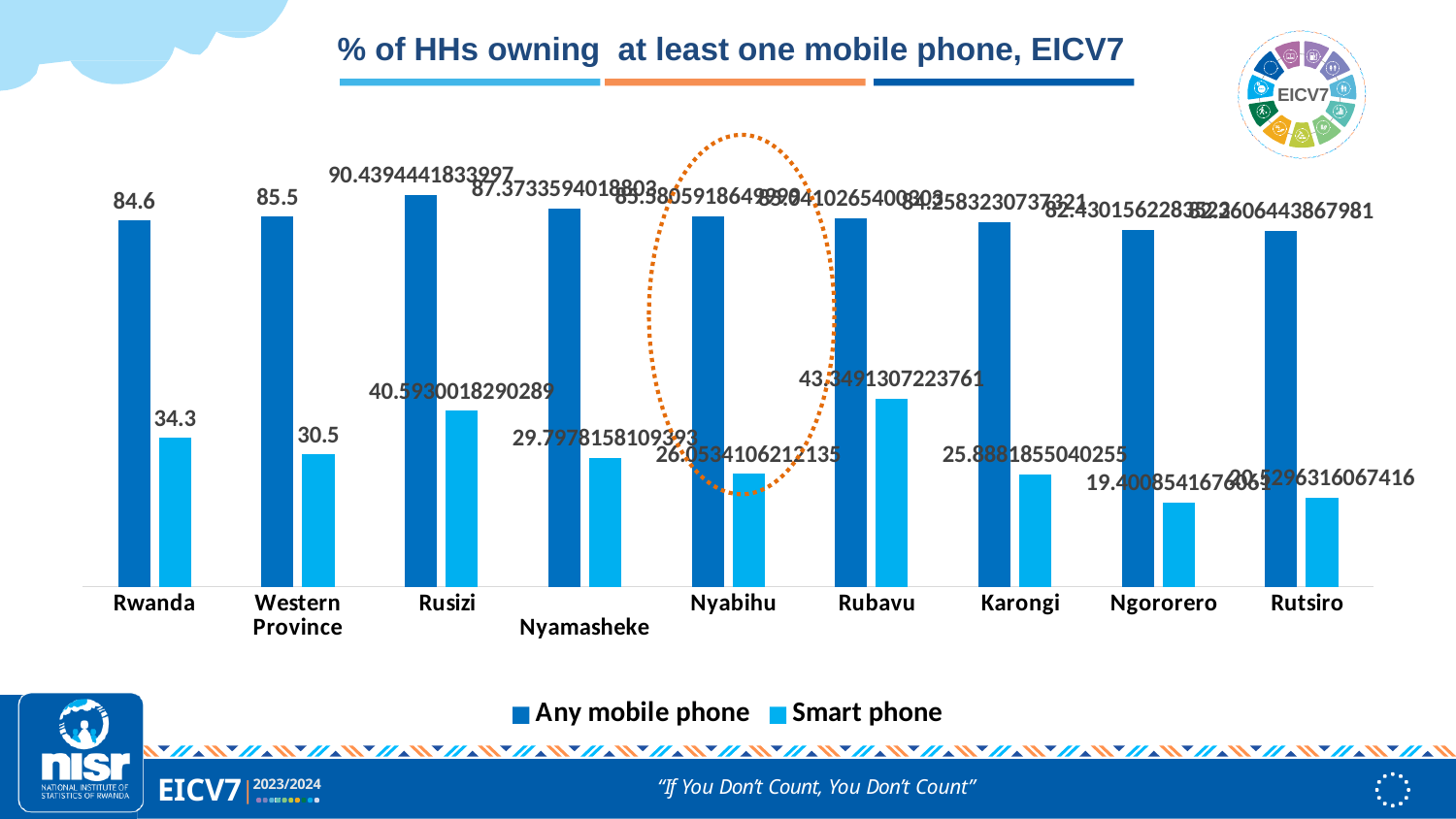
What is the difference between the Any mobile phone and Smart phone values for Rwanda? 50.3 How many categories are shown on the x axis? 9 What type of chart is shown on the slide? Bar chart Which category has the highest value for Smart phone? Rubavu What is the value for Any mobile phone in Rwanda? 84.6 What is the value for Smart phone in Western Province? 30.5 Which has a larger Smart phone value, Rwanda or Western Province? Rwanda What is the value for Smart phone in Rwanda? 34.3 What is the value for Any mobile phone in Western Province? 85.5 How many series does the legend list? 2 Which category has the highest value for Any mobile phone? Rusizi What is the value for Smart phone in Rubavu? 43.3491307223761